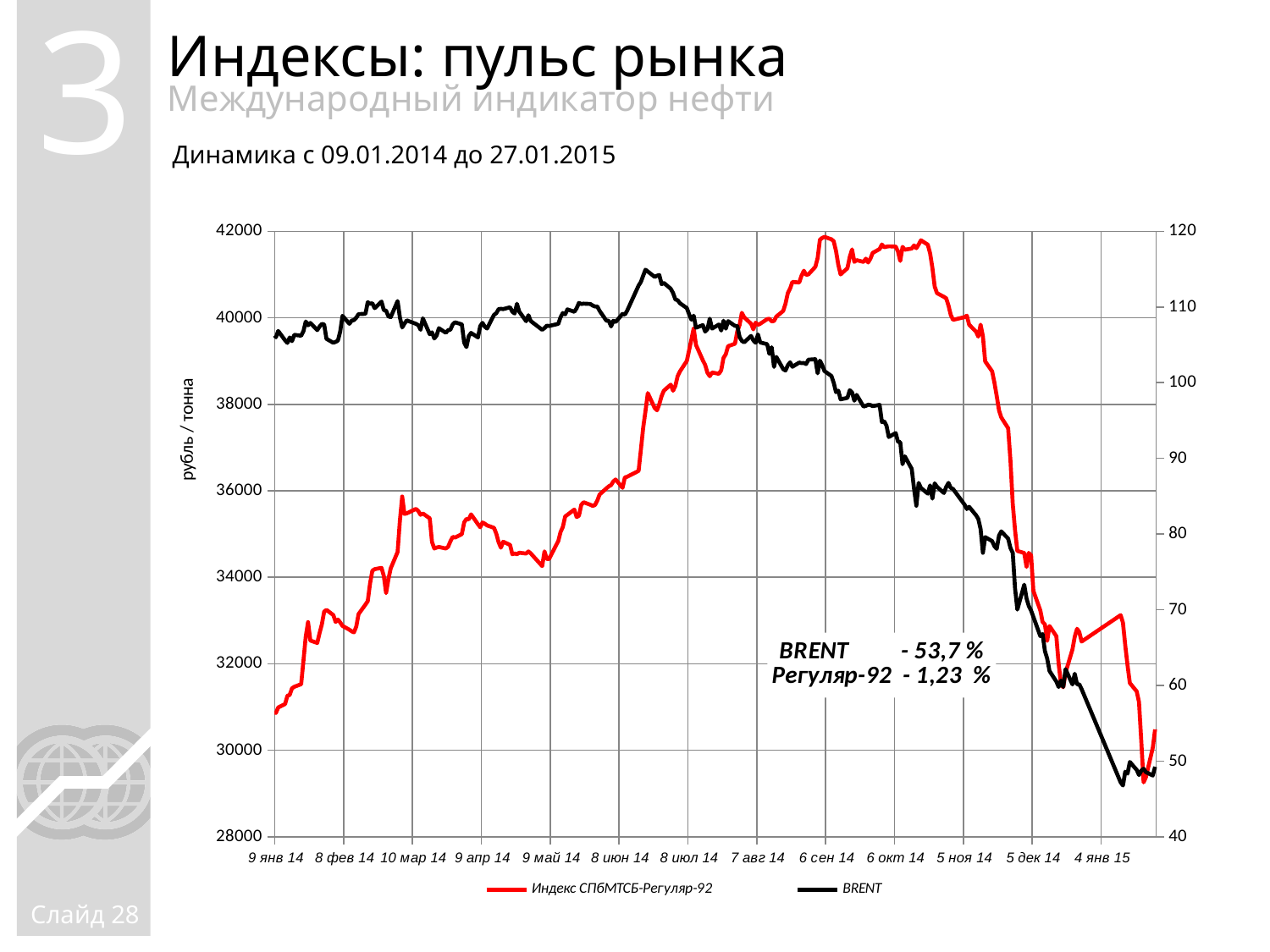
What kind of chart is shown on the slide? line chart Does the BRENT series rise or fall overall from the start to the end of the period shown? fall What percentage change is printed on the chart for Регуляр-92? - 1,23 % What are the two series named in the chart legend? Индекс СПбМТСБ-Регуляр-92 and BRENT What percentage change is printed on the chart for BRENT? - 53,7 % Is the value of Индекс СПбМТСБ-Регуляр-92 at 9 янв 14 greater or less than 32000? less Is the BRENT value at 9 янв 14 greater or less than 100 on the right axis? greater How many date labels are shown along the x axis of the chart? 13 How many series does the chart legend list? 2 Is the peak value of Индекс СПбМТСБ-Регуляр-92 in October 2014 greater or less than 40000? greater Does the Индекс СПбМТСБ-Регуляр-92 series rise or fall between 9 янв 14 and 6 окт 14? rise What is the label on the left vertical axis of the chart? рубль / тонна